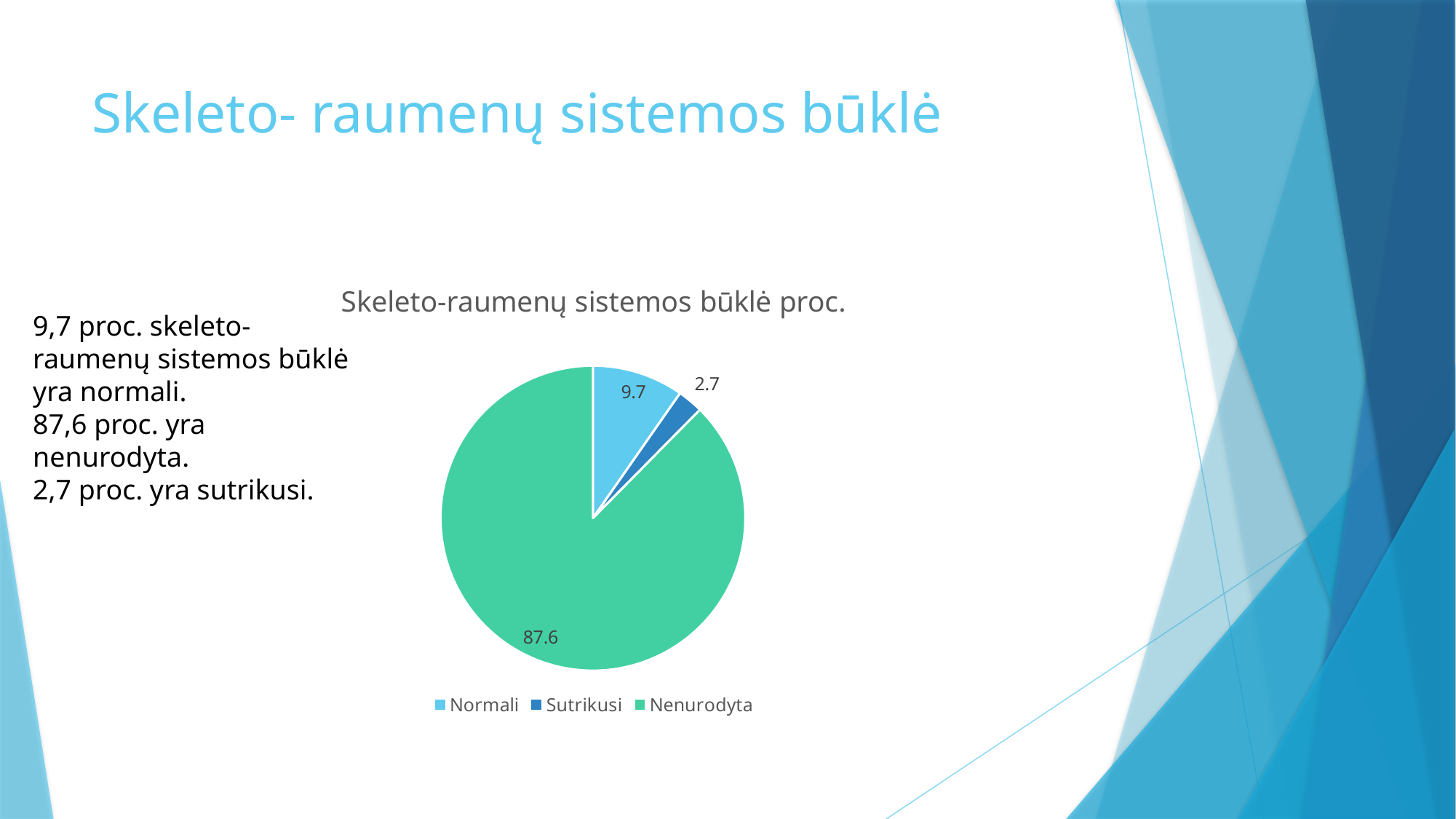
What type of chart is shown on the slide? pie chart What is the difference between the values for Nenurodyta and Normali? 77.9 What is the title of the chart? Skeleto-raumenų sistemos būklė proc. How many categories does the pie chart have? 3 What is the difference between the values for Normali and Sutrikusi? 7 Which category has the smallest slice? Sutrikusi Which category has the largest slice? Nenurodyta Which is larger, the value for Normali or the value for Sutrikusi? Normali What is the value for Nenurodyta? 87.6 Which colour represents Nenurodyta in the legend? green What is the value for Normali? 9.7 What is the value for Sutrikusi? 2.7